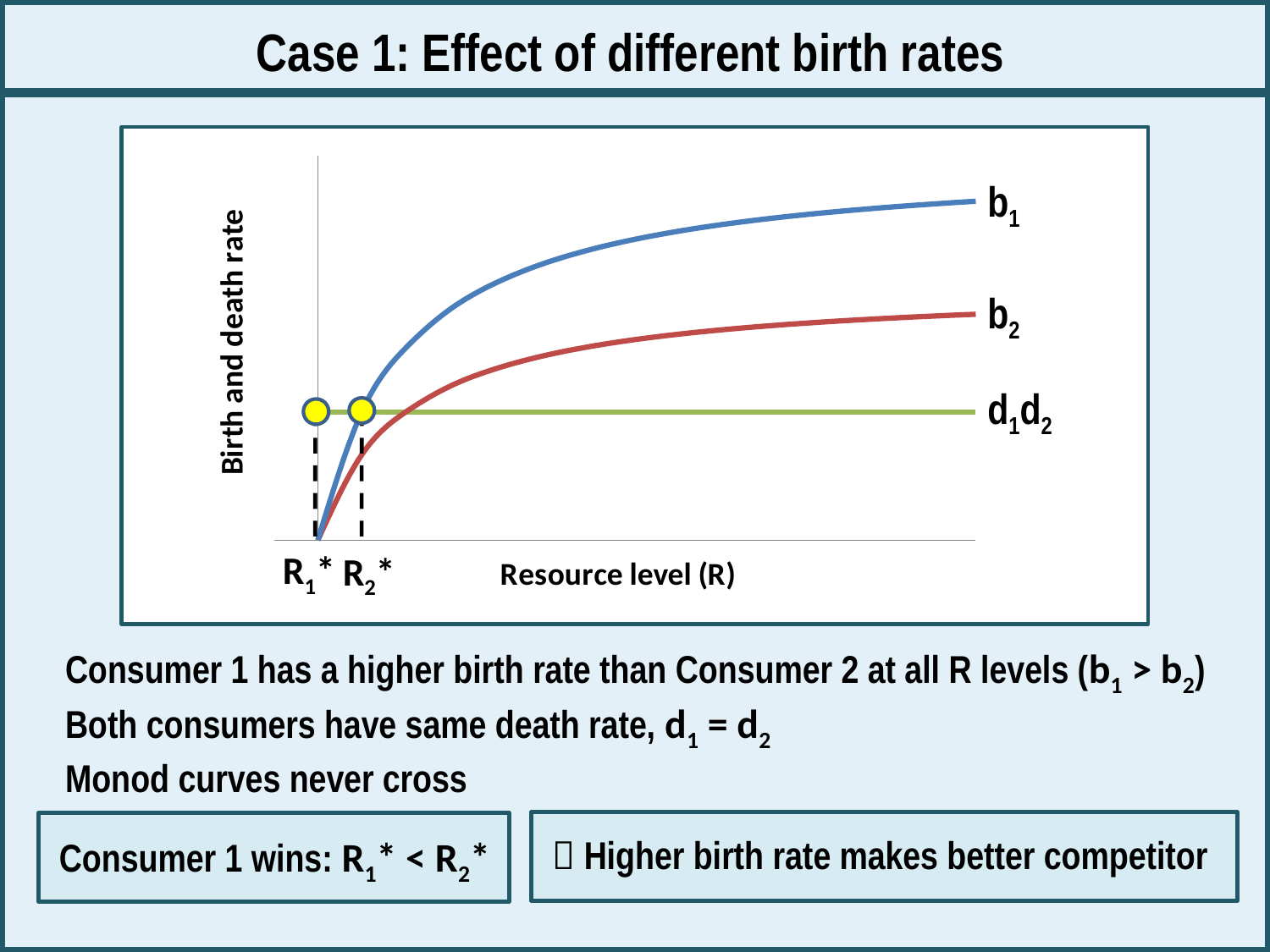
Which curve on the chart is flat (horizontal) across all resource levels? d1d2 How many curves are plotted on the chart? 3 What kind of chart is shown on the slide? Line chart Does the b1 curve rise or fall as resource level increases? Rises Does the b2 curve rise or fall as resource level increases? Rises What is the label of the x axis of the chart? Resource level (R) Which curve is the lowest at high resource levels? d1d2 Which curve is the highest at high resource levels? b1 Which curve lies higher on the chart at high resource levels, b1 or b2? b1 What is the label of the y axis of the chart? Birth and death rate Which is located further left on the x axis, R1* or R2*? R1* How many yellow marker points are shown on the chart? 2